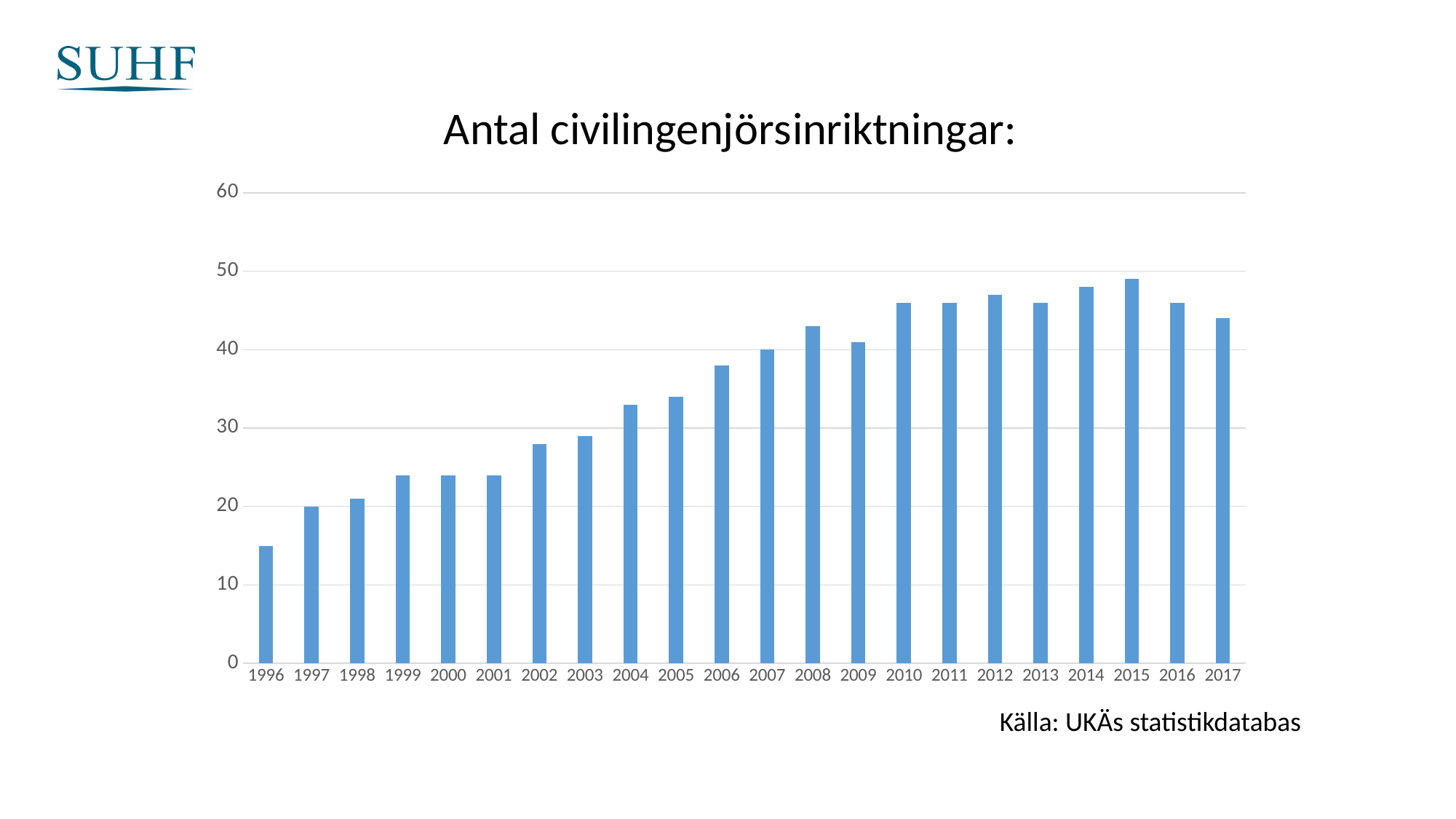
What is the title of the chart? Antal civilingenjörsinriktningar: How many years are shown on the x axis of the chart? 22 Is the value for 1996 greater or less than 20? less What kind of chart is shown on the slide? bar chart Is the value for 2010 greater or less than 40? greater Is the value for 2004 greater or less than 30? greater Which year has the lowest value in the chart? 1996 Do the values generally rise or fall from 1996 to 2015? rise Which year has the highest value in the chart? 2015 Which year has the larger value, 2005 or 2006? 2006